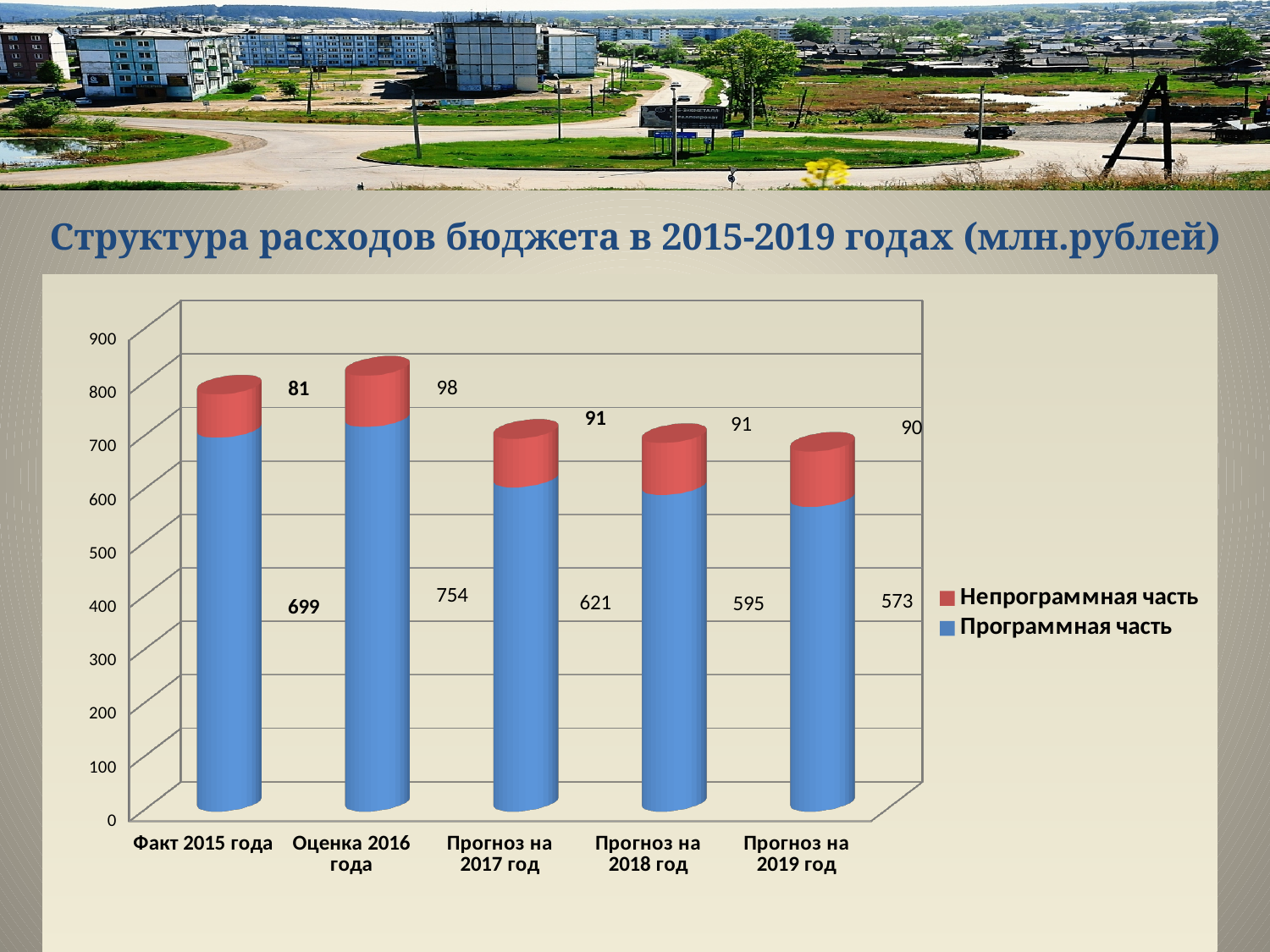
What is the total of the stacked bar for Прогноз на 2019 год? 663 What is the value of Программная часть for Оценка 2016 года? 754 What is the value of Непрограммная часть for Факт 2015 года? 81 What is the total of the stacked bar for Оценка 2016 года? 852 How many series does the legend list? 2 Which category has the highest value of Программная часть? Оценка 2016 года How many categories are shown on the x axis? 5 What is the difference between Программная часть for Оценка 2016 года and for Прогноз на 2017 год? 133 What is the value of Программная часть for Прогноз на 2019 год? 573 Which is larger: Программная часть for Факт 2015 года or for Прогноз на 2018 год? Факт 2015 года Which category has the lowest value of Непрограммная часть? Факт 2015 года What kind of chart is shown on the slide? Stacked bar chart